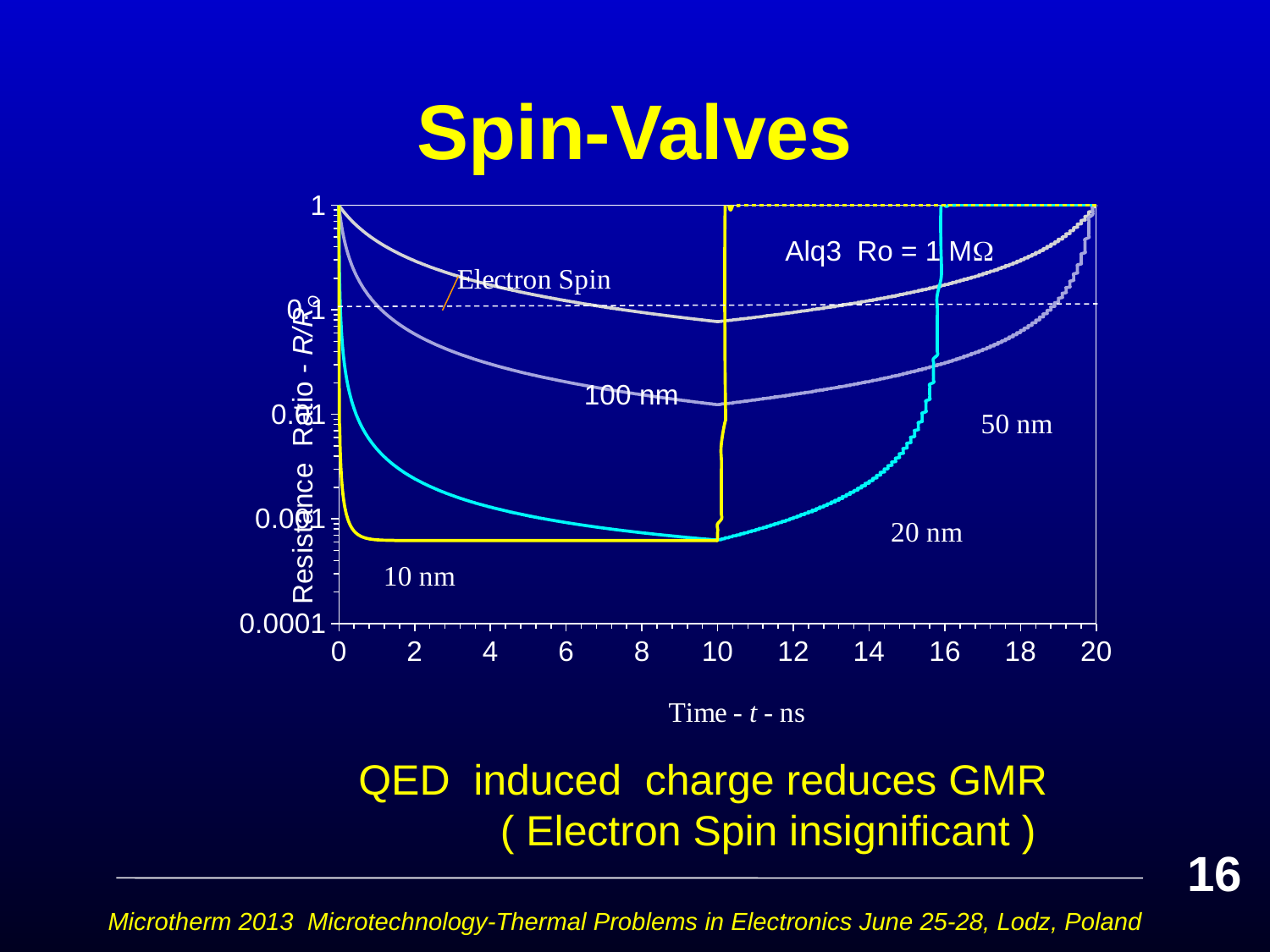
Is the value of the 20 nm curve at 10 ns greater or less than 0.001? less Which of the thickness curves (10 nm, 20 nm, 50 nm, 100 nm) has the lowest value at 5 ns? 10 nm What is the highest value shown on the x axis of the chart? 20 What is the label of the y axis of the chart? Resistance Ratio - R/Ro What is the label of the x axis of the chart? Time - t - ns At 5 ns, which curve has the larger value, 100 nm or 10 nm? 100 nm Is the value of the 100 nm curve at 2 ns greater or less than 0.1? less What is the lowest value shown on the y axis of the chart? 0.0001 Is the value of the 10 nm curve at 5 ns greater or less than 0.001? less What kind of chart is shown on the slide? line chart Does the 20 nm curve rise or fall between 10 ns and 16 ns? rise